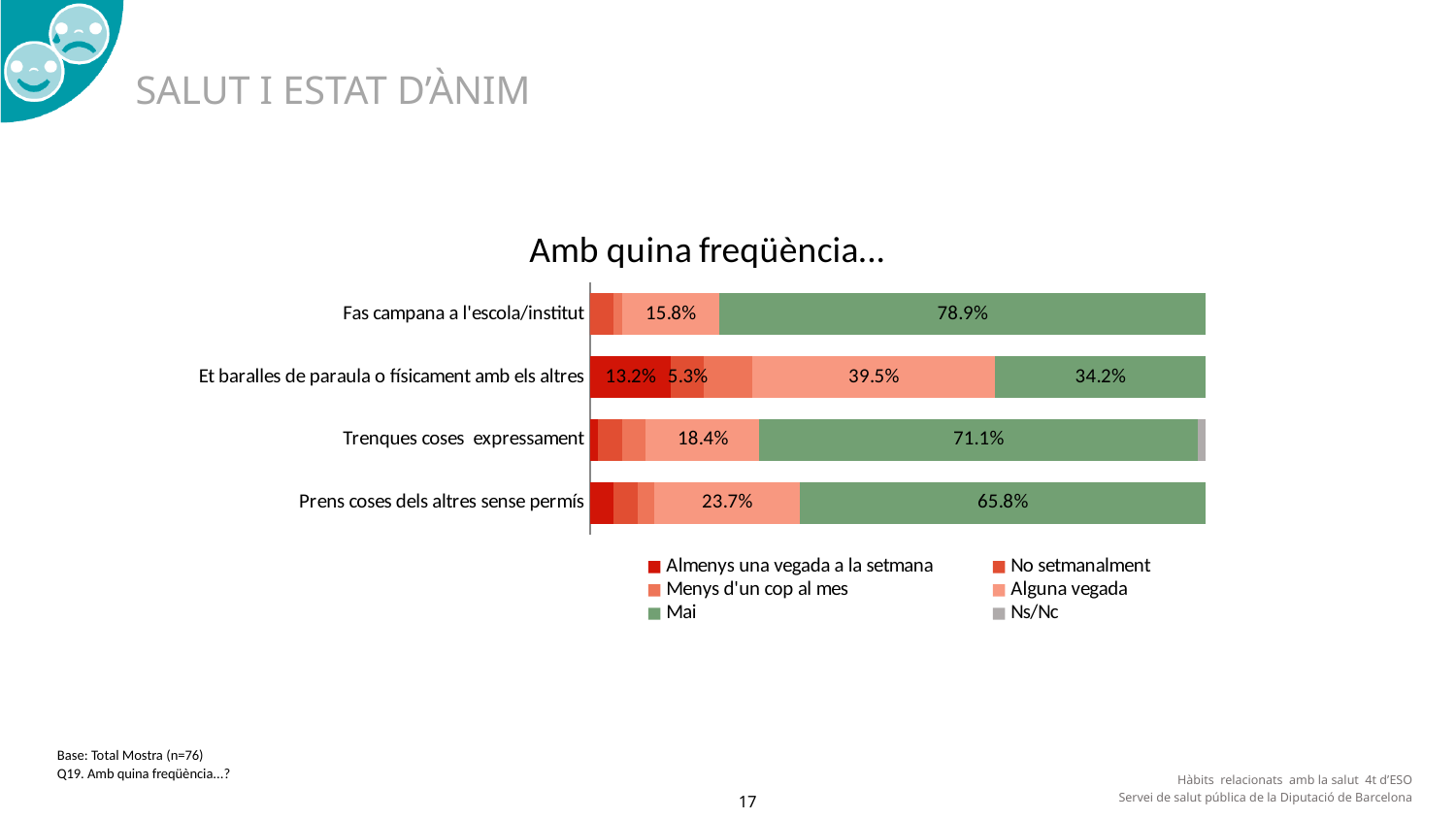
What is the "Almenys una vegada a la setmana" value for "Et baralles de paraula o físicament amb els altres"? 13.2% What is the "Mai" value for "Trenques coses expressament"? 71.1% Which has a larger "Alguna vegada" value: "Trenques coses expressament" or "Prens coses dels altres sense permís"? Prens coses dels altres sense permís Which category has the highest "Mai" percentage? Fas campana a l'escola/institut How many categories (behaviours) are shown in the chart? 4 What is the difference between the "Mai" values for "Fas campana a l'escola/institut" and "Prens coses dels altres sense permís"? 13.1 percentage points What is the "Alguna vegada" value for "Prens coses dels altres sense permís"? 23.7% Which category has the lowest "Mai" percentage? Et baralles de paraula o físicament amb els altres How many series does the legend list? 6 What percentage of respondents answered "Mai" for "Fas campana a l'escola/institut"? 78.9% What type of chart is shown on the slide? Stacked bar chart What is the "Alguna vegada" value for "Et baralles de paraula o físicament amb els altres"? 39.5%